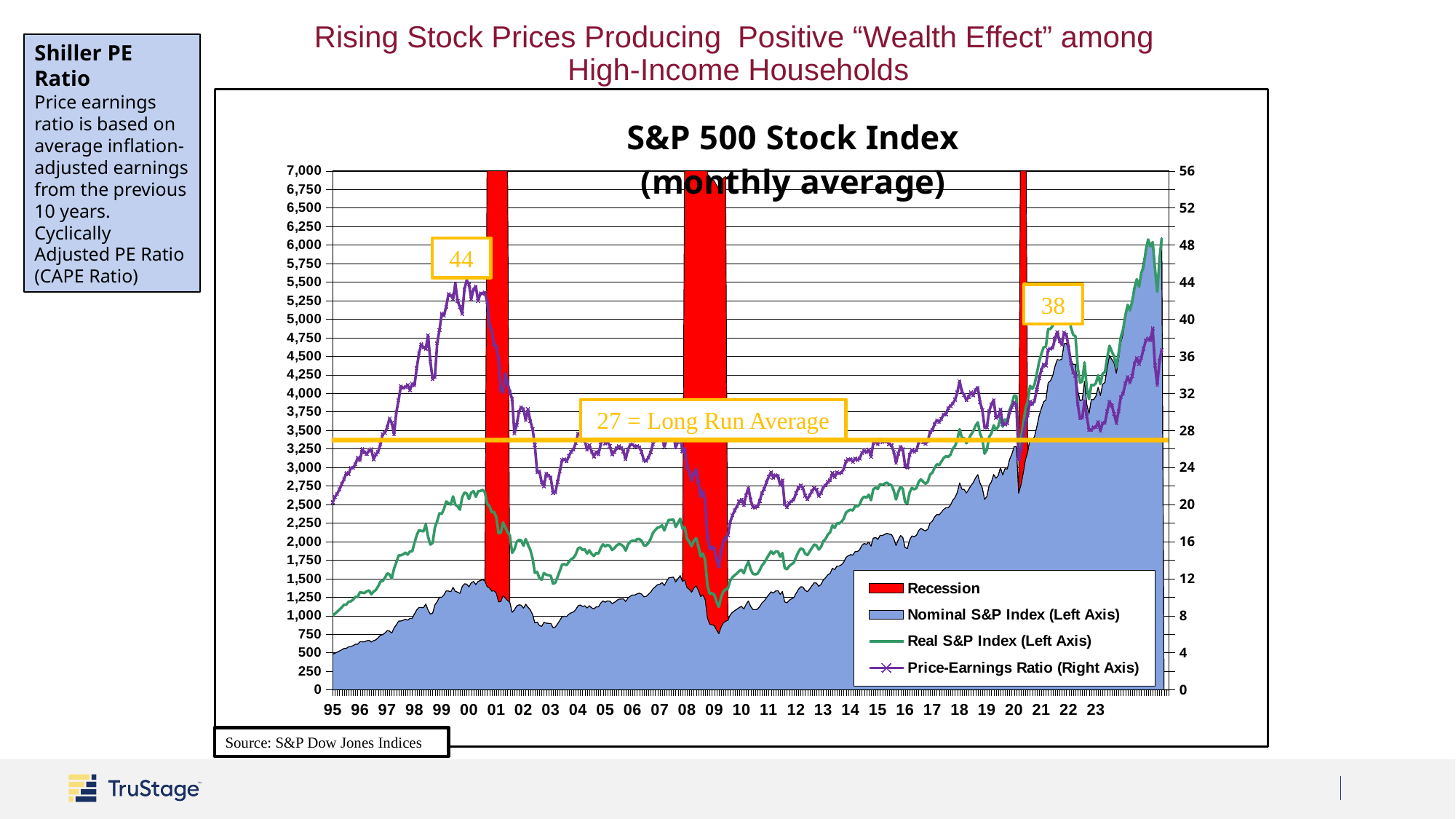
Is the Price-Earnings Ratio at its 2009 low greater or less than 16? less Is the Nominal S&P Index value in 1995 greater or less than 1,000? less What is the title of the chart on the slide? S&P 500 Stock Index (monthly average) According to the annotation on the chart, what is the long run average of the Price-Earnings Ratio? 27 What value is annotated at the Price-Earnings Ratio peak around 2021? 38 How many series does the chart's legend list? 4 How many recession periods are shaded on the chart? 3 What value is annotated at the Price-Earnings Ratio peak around 2000? 44 Is the Nominal S&P Index value at the end of 2023 greater or less than 4,000? greater Around 2000, which is higher, the Real S&P Index or the Nominal S&P Index? Real S&P Index Does the Nominal S&P Index generally rise or fall from 1995 to 2023? rise On which axis is the Price-Earnings Ratio plotted? Right axis